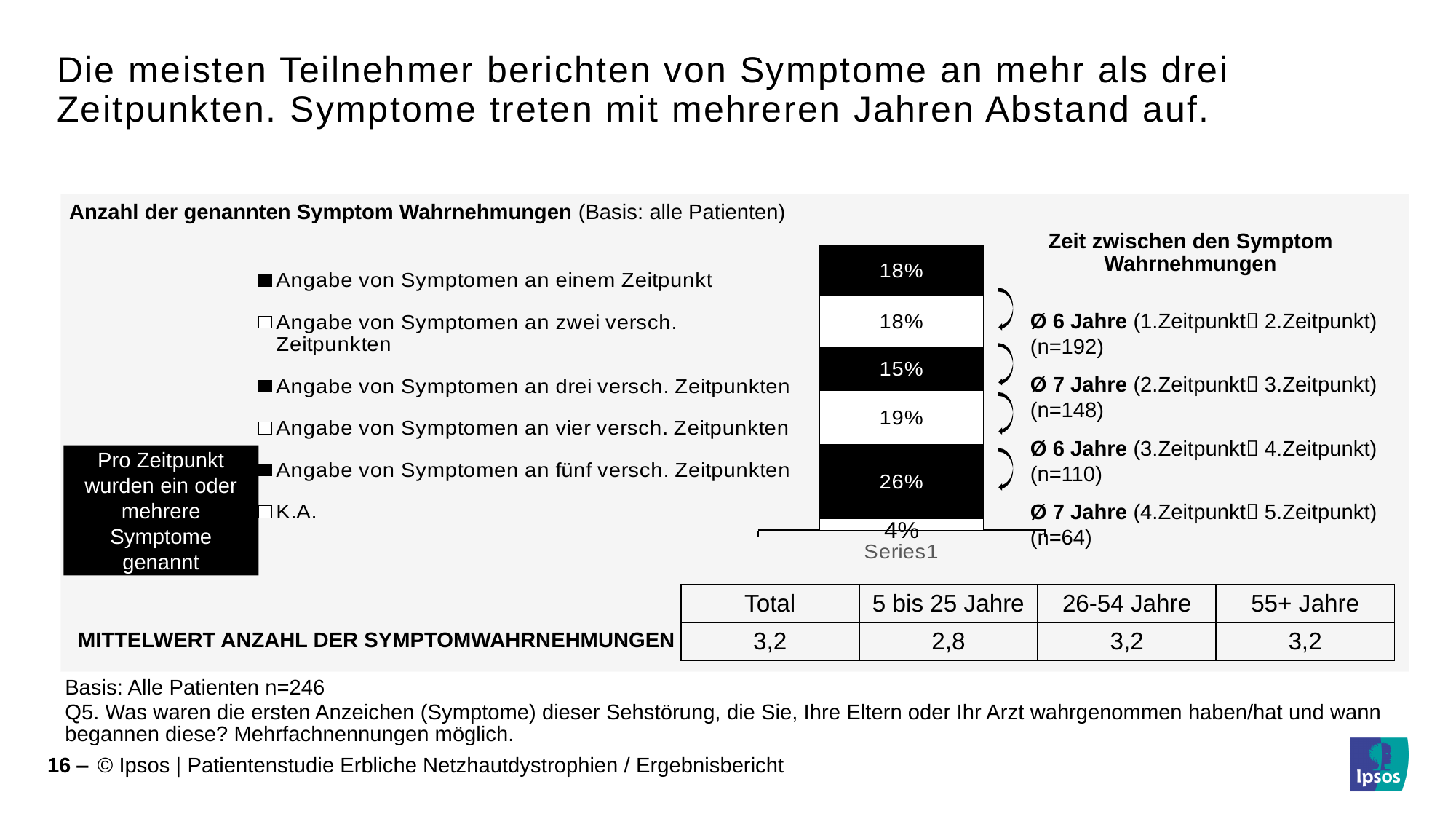
What percentage is shown for 'Angabe von Symptomen an fünf versch. Zeitpunkten'? 26% What percentage is shown for 'K.A.'? 4% What is the difference between the segment for five time points (26%) and the segment for four time points (19%)? 7% What percentage is shown for 'Angabe von Symptomen an vier versch. Zeitpunkten'? 19% What label appears on the x axis under the stacked bar? Series1 What kind of chart is shown on the slide? stacked bar chart Which is larger: the segment for three time points or the segment for four time points? Angabe von Symptomen an vier versch. Zeitpunkten How many entries does the legend of the chart list? 6 Which legend category has the smallest segment in the stacked bar? K.A. What is the total of all segments in the stacked bar? 100% Which legend category has the largest segment in the stacked bar? Angabe von Symptomen an fünf versch. Zeitpunkten What percentage is shown for 'Angabe von Symptomen an drei versch. Zeitpunkten'? 15%